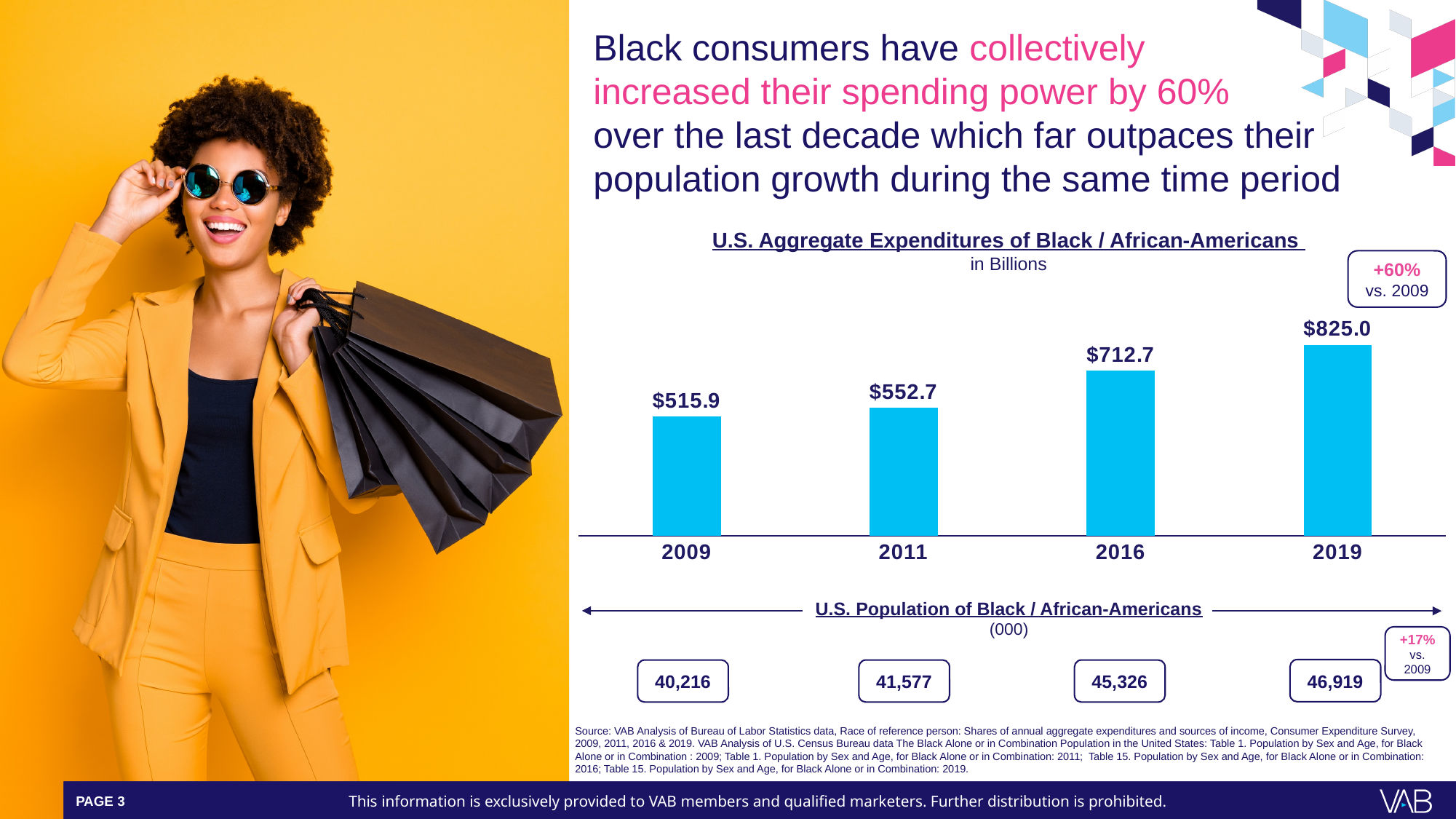
What is the value for 2019 in the U.S. Aggregate Expenditures chart? $825.0 In the U.S. Aggregate Expenditures chart, which is larger, the value for 2011 or the value for 2016? 2016 What is the difference between the 2019 and 2009 values in the U.S. Aggregate Expenditures chart? $309.1 What is the value for 2011 in the U.S. Aggregate Expenditures chart? $552.7 What kind of chart is the U.S. Aggregate Expenditures of Black / African-Americans chart? Bar chart What is the value for 2009 in the U.S. Aggregate Expenditures of Black / African-Americans chart? $515.9 What is the difference between the 2016 and 2011 values in the U.S. Aggregate Expenditures chart? $160.0 What is the value for 2016 in the U.S. Aggregate Expenditures chart? $712.7 Do the values in the U.S. Aggregate Expenditures chart rise or fall from 2009 to 2019? Rise Which year has the highest value in the U.S. Aggregate Expenditures chart? 2019 How many years are shown in the U.S. Aggregate Expenditures chart? 4 Which year has the lowest value in the U.S. Aggregate Expenditures chart? 2009